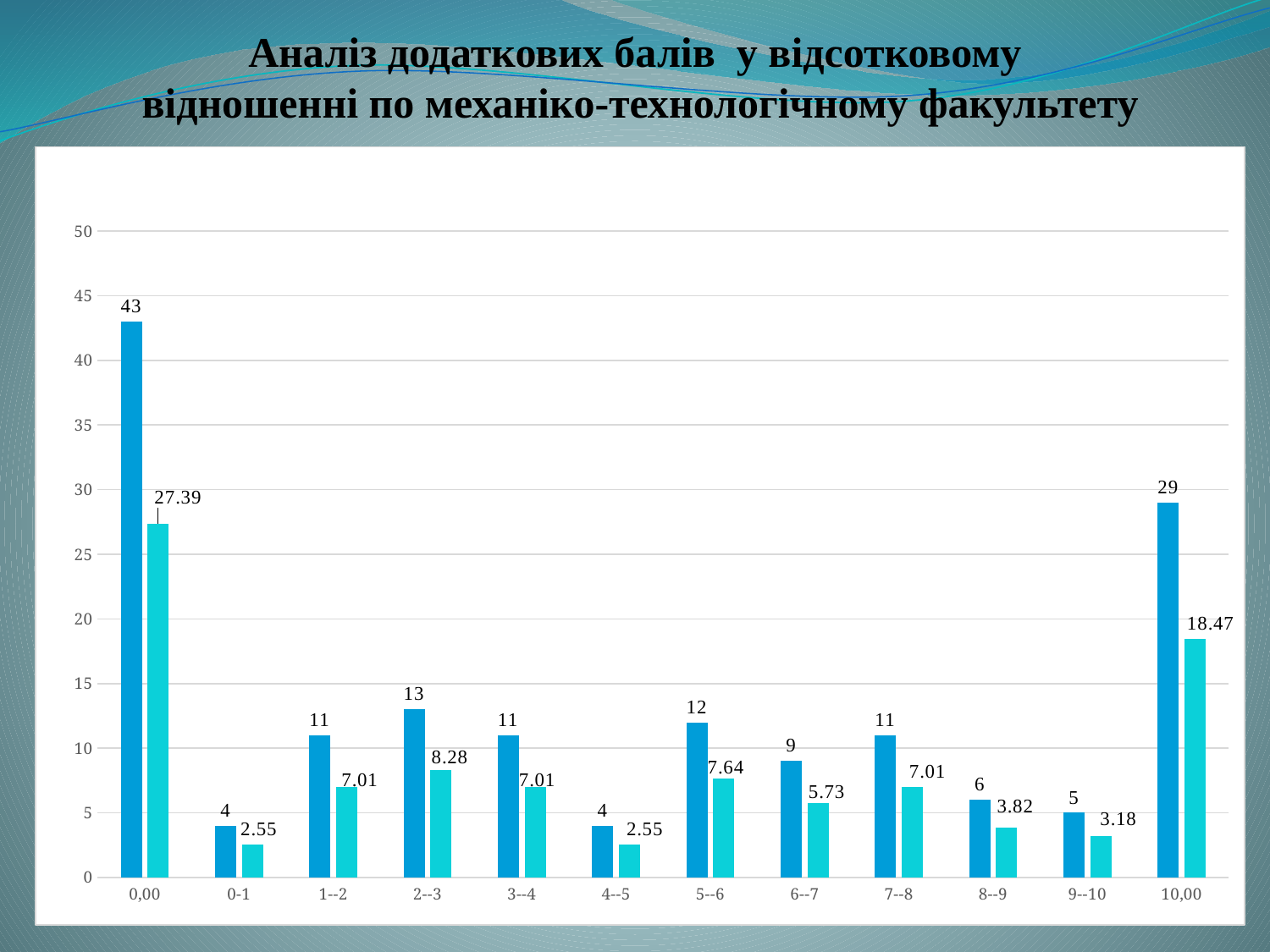
What is the value of the dark blue bar for the category 0,00? 43 Which is larger: the dark blue bar for 2--3 or the dark blue bar for 6--7? 2--3 What is the value of the dark blue bar for the category 5--6? 12 What kind of chart is shown on the slide? bar chart Which category has the highest dark blue bar? 0,00 How many categories are shown on the x axis of the chart? 12 What is the difference between the dark blue bars for 0,00 and 10,00? 14 What is the difference between the light cyan bars for 5--6 and 6--7? 1.91 Is the light cyan bar for 0,00 greater or less than 25? greater What is the value of the light cyan bar for the category 10,00? 18.47 What is the value of the light cyan bar for the category 2--3? 8.28